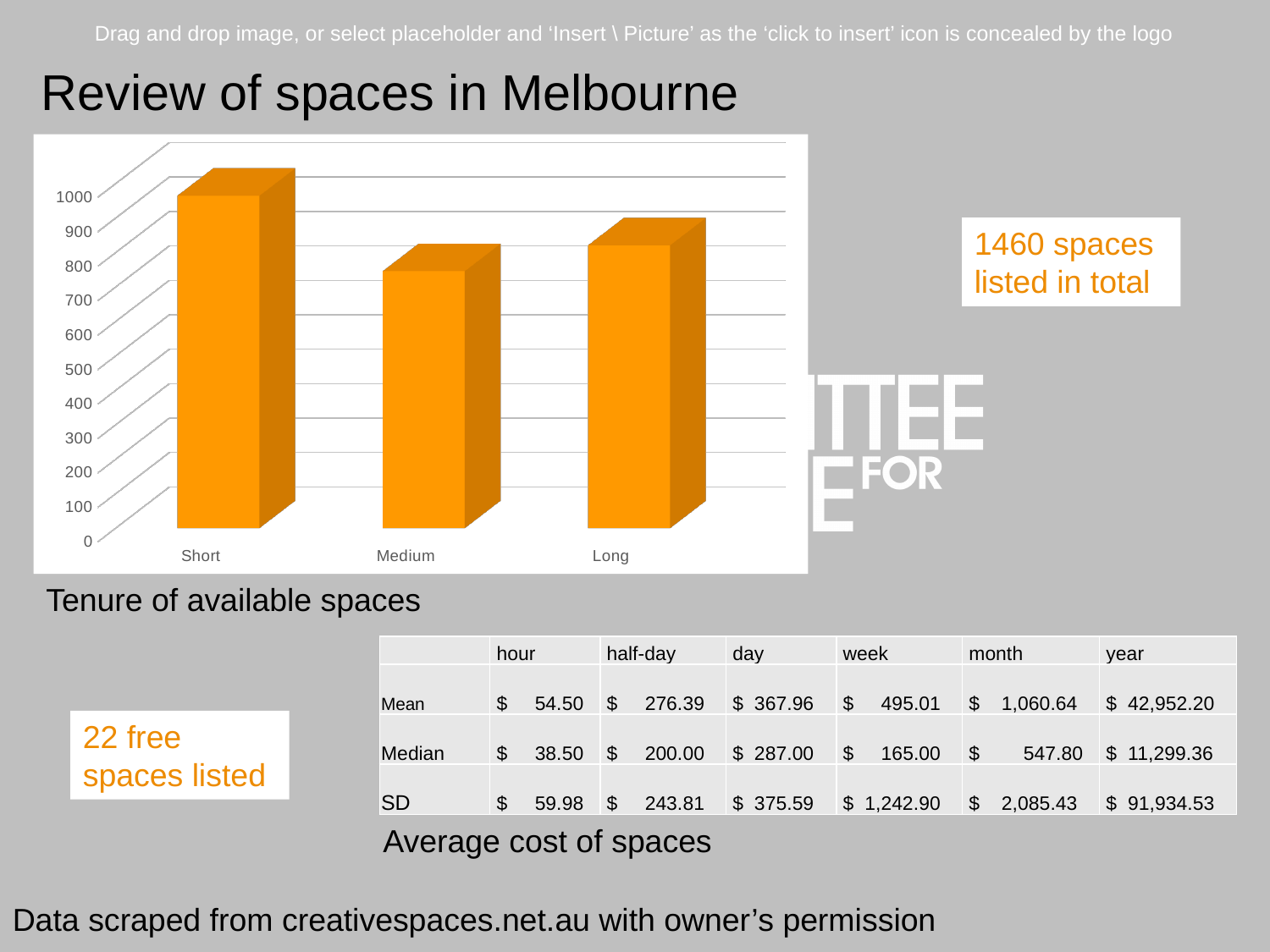
What kind of chart is shown on the slide? bar chart Is the value for Short greater or less than 900? greater Which category has the highest bar in the chart? Short Is the value for Medium greater or less than 900? less Is the value for Medium greater or less than 700? greater Which bar is taller, Short or Long? Short What colour are the bars in the chart? orange Which category has the lowest bar in the chart? Medium Which bar is taller, Long or Medium? Long What caption appears directly below the bar chart? Tenure of available spaces How many categories are shown on the x axis of the bar chart? 3